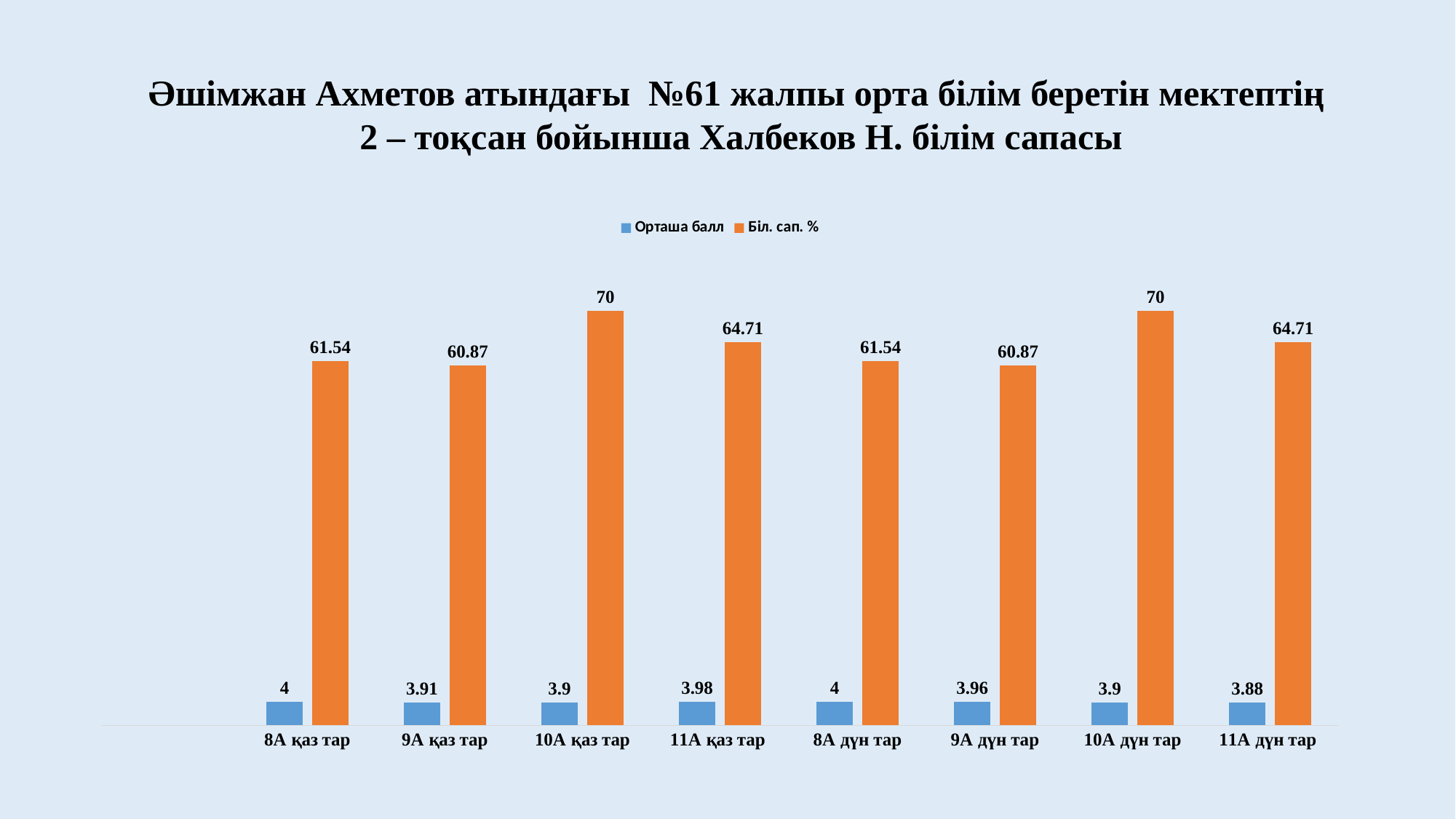
Which is larger, the Біл. сап. % value for 10А қаз тар or for 11А қаз тар? 10А қаз тар How many categories are shown on the x axis? 8 What is the Орташа балл value for 11А қаз тар? 3.98 How many series does the legend list? 2 What kind of chart is shown on the slide? Bar chart What is the difference between the Біл. сап. % values for 11А дүн тар and 9А дүн тар? 3.84 Which series is shown in orange? Біл. сап. % What is the Біл. сап. % value for 10А қаз тар? 70 What is the difference between the Біл. сап. % values for 10А қаз тар and 8А қаз тар? 8.46 Which category has the lowest Орташа балл value? 11А дүн тар What is the Біл. сап. % value for 9А дүн тар? 60.87 What is the Орташа балл value for 11А дүн тар? 3.88